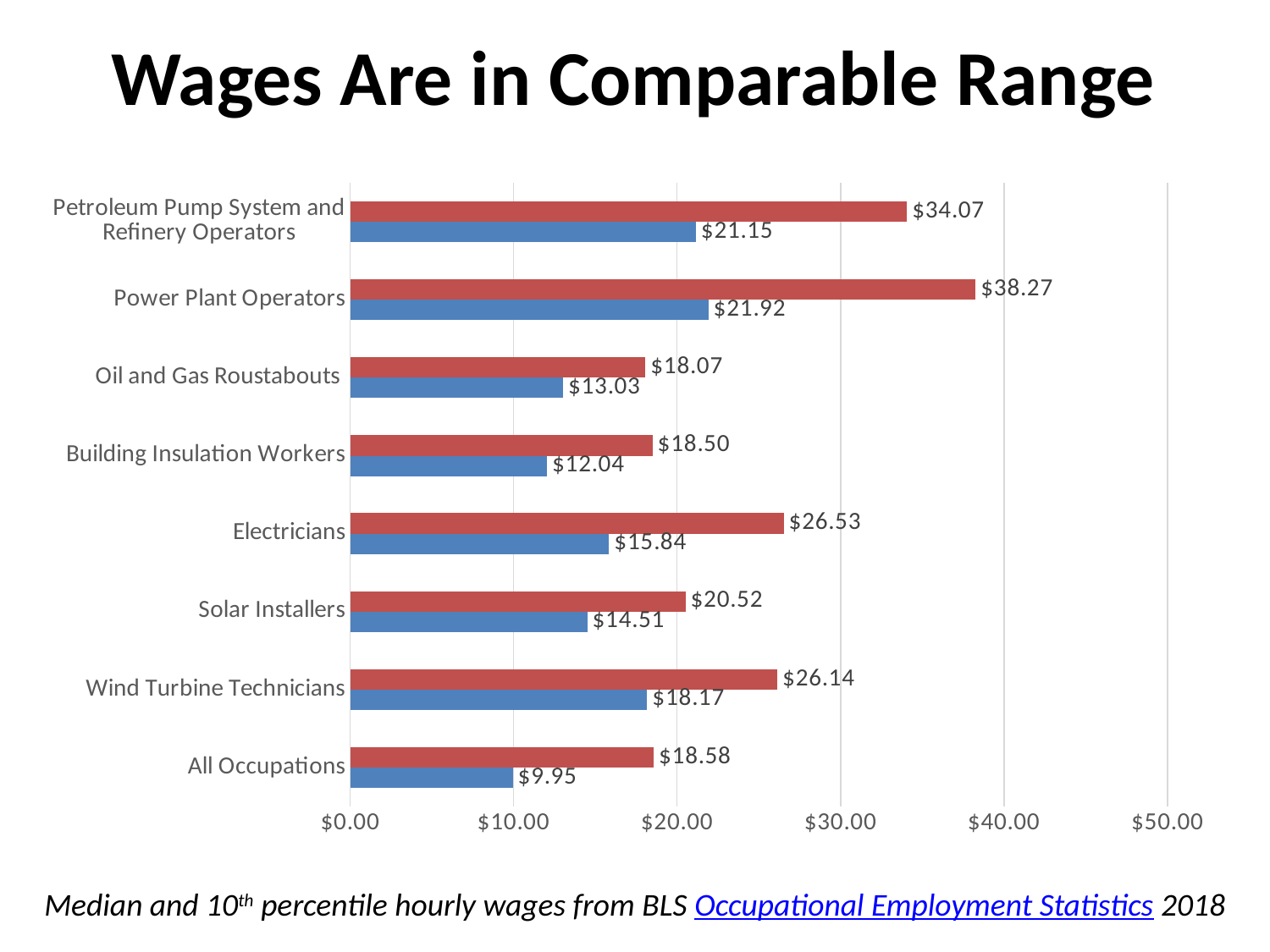
What is the value of the blue bar for Wind Turbine Technicians? $18.17 How many occupation categories are shown on the chart? 8 What is the value of the red bar for Power Plant Operators? $38.27 Which occupation has the highest red bar value? Power Plant Operators What is the value of the red bar for Solar Installers? $20.52 Is the red bar value for Petroleum Pump System and Refinery Operators greater or less than $30.00? greater Which occupation has the lowest red bar value? Oil and Gas Roustabouts What is the value of the blue bar for All Occupations? $9.95 What is the difference between the red and blue bar values for Power Plant Operators? $16.35 What kind of chart is shown on the slide? bar chart Which is larger: the red bar for Electricians or the red bar for Wind Turbine Technicians? Electricians Which occupation has the lowest blue bar value? All Occupations